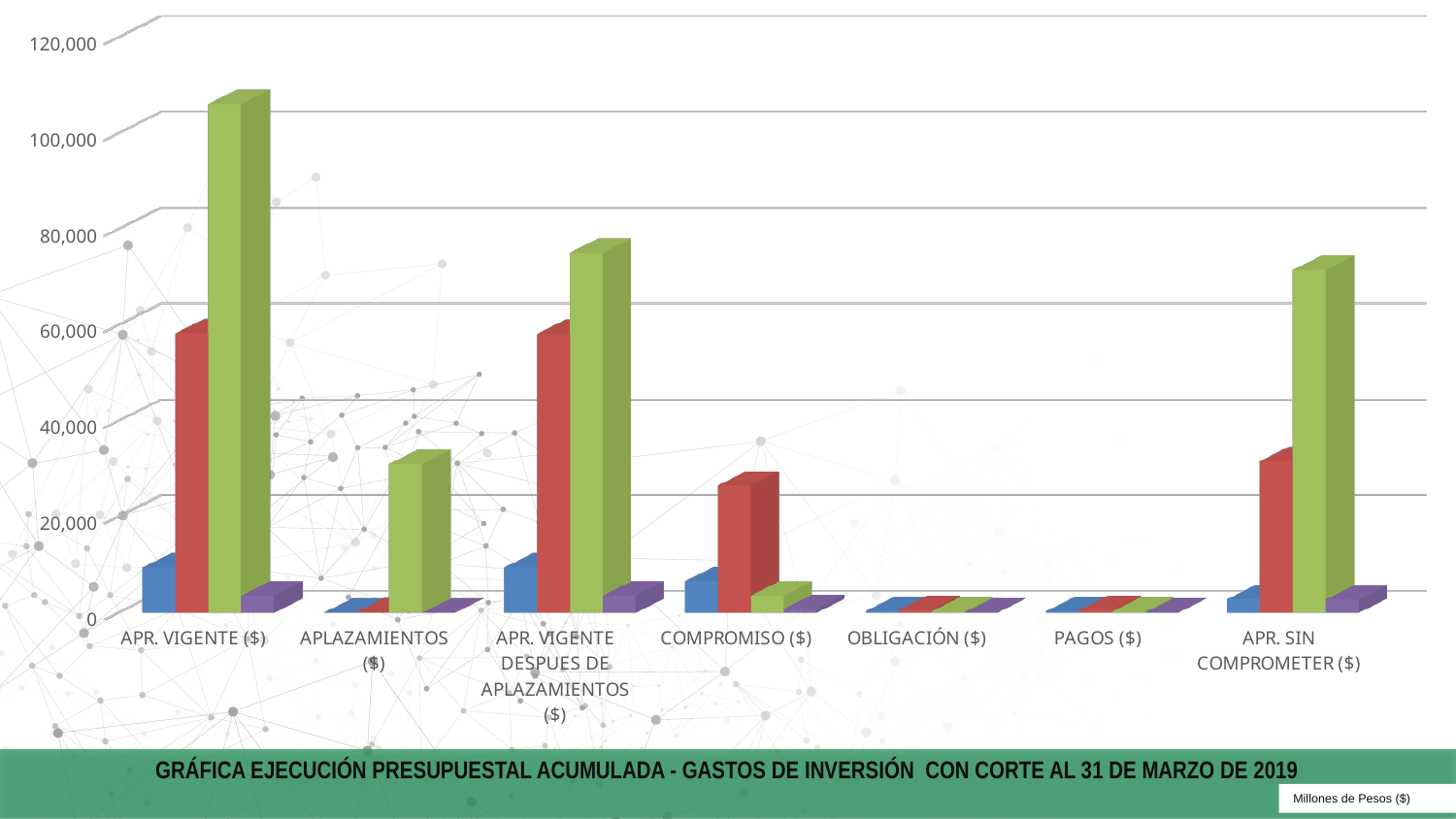
Is the value of the green bar for APLAZAMIENTOS ($) greater or less than 20,000? greater What unit is stated for the values in the chart? Millones de Pesos ($) Is the value of the blue bar for APR. VIGENTE ($) greater or less than 20,000? less Which category has the tallest green bar? APR. VIGENTE ($) Is the value of the red bar for COMPROMISO ($) greater or less than 20,000? greater Which is larger: the green bar for APR. VIGENTE ($) or the green bar for APR. SIN COMPROMETER ($)? APR. VIGENTE ($) Which is larger: the red bar for COMPROMISO ($) or the red bar for APR. SIN COMPROMETER ($)? APR. SIN COMPROMETER ($) What kind of chart is shown on the slide? Bar chart How many categories are shown along the x axis of the chart? 7